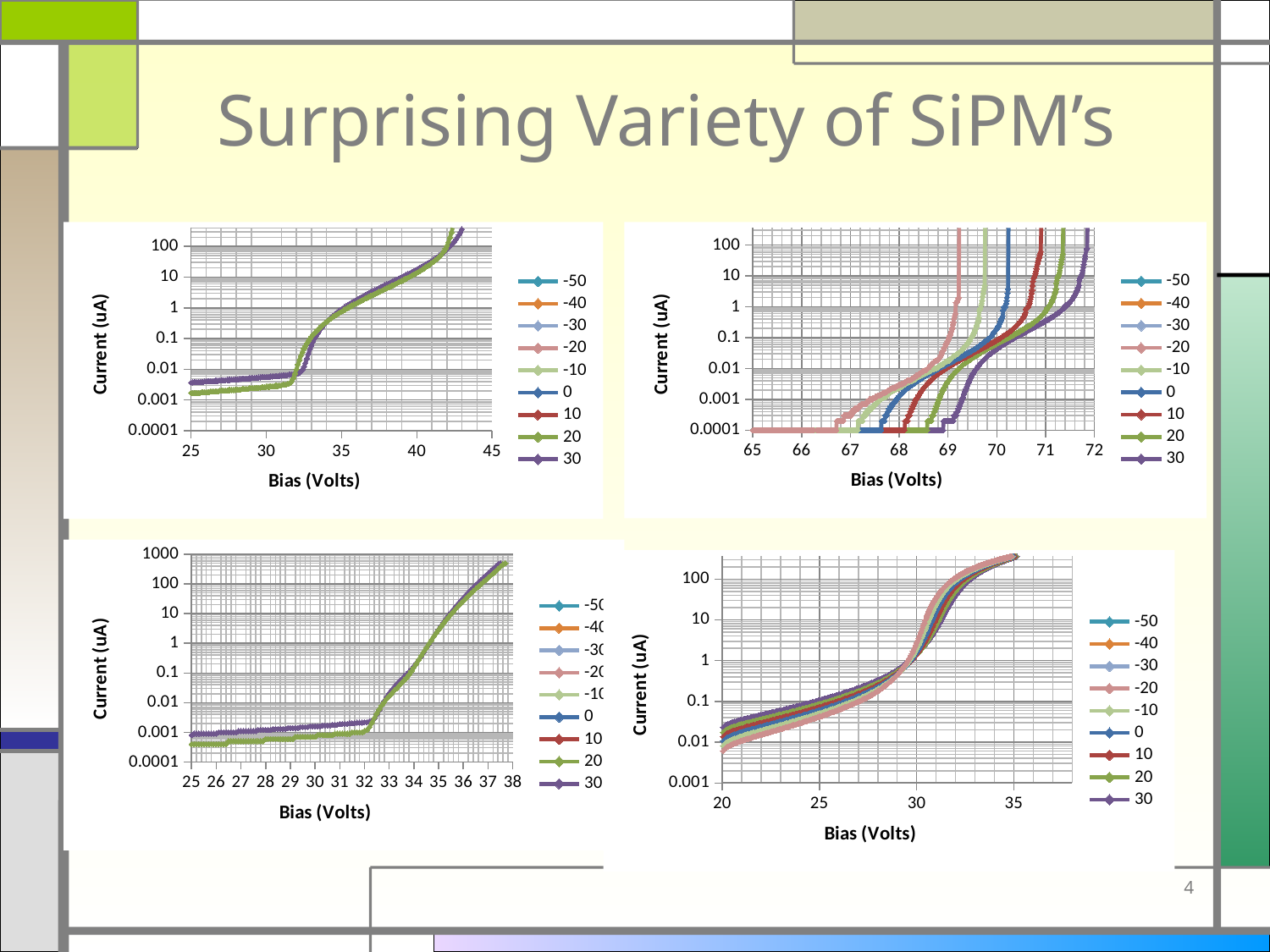
In the top-left chart, how many series does the legend list? 9 In the top-left chart, is the current at a bias of 30 volts greater or less than 0.01? less What is the x-axis label of the bottom-right chart? Bias (Volts) What kind of chart is the bottom-right chart? line chart In the top-left chart, is the current at a bias of 40 volts greater or less than 1? greater In the top-left chart, does the current rise or fall as the bias increases? rise In the top-right chart, how many series does the legend list? 9 What is the y-axis label of the top-right chart? Current (uA) In the bottom-left chart, is the current at a bias of 30 volts greater or less than 0.01? less How many charts are shown on the slide? 4 In the top-right chart, does the current rise or fall as the bias increases? rise